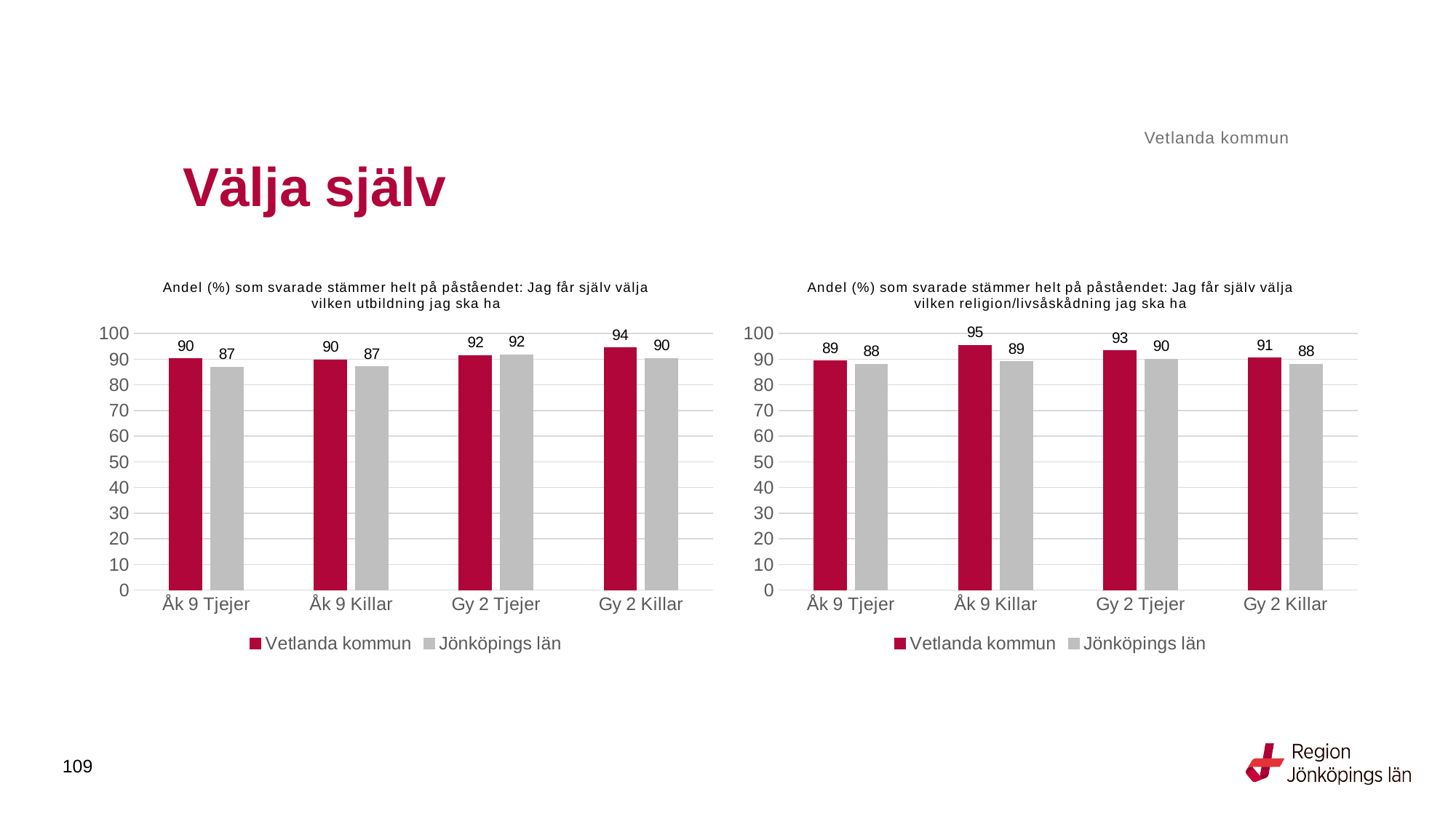
In the right chart (about choosing religion), which category has the highest value for Vetlanda kommun? Åk 9 Killar In the right chart (about choosing religion), what is the value for Vetlanda kommun for Åk 9 Killar? 95 In the left chart (about choosing education), what is the difference between Vetlanda kommun and Jönköpings län for Gy 2 Killar? 4 What type of chart is the left chart? Bar chart In the left chart (about choosing education), what is the value for Vetlanda kommun for Gy 2 Killar? 94 In the left chart (about choosing education), which category has the lowest value for Jönköpings län? Åk 9 Tjejer and Åk 9 Killar (both 87) In the right chart (about choosing religion), what is the value for Jönköpings län for Gy 2 Tjejer? 90 In the left chart (about choosing education), what is the value for Jönköpings län for Åk 9 Tjejer? 87 How many categories are shown on the x axis of the left chart? 4 In the right chart (about choosing religion), which is larger for Gy 2 Tjejer: Vetlanda kommun or Jönköpings län? Vetlanda kommun How many series does the legend of the right chart list? 2 In the right chart (about choosing religion), what is the difference between Vetlanda kommun and Jönköpings län for Åk 9 Killar? 6